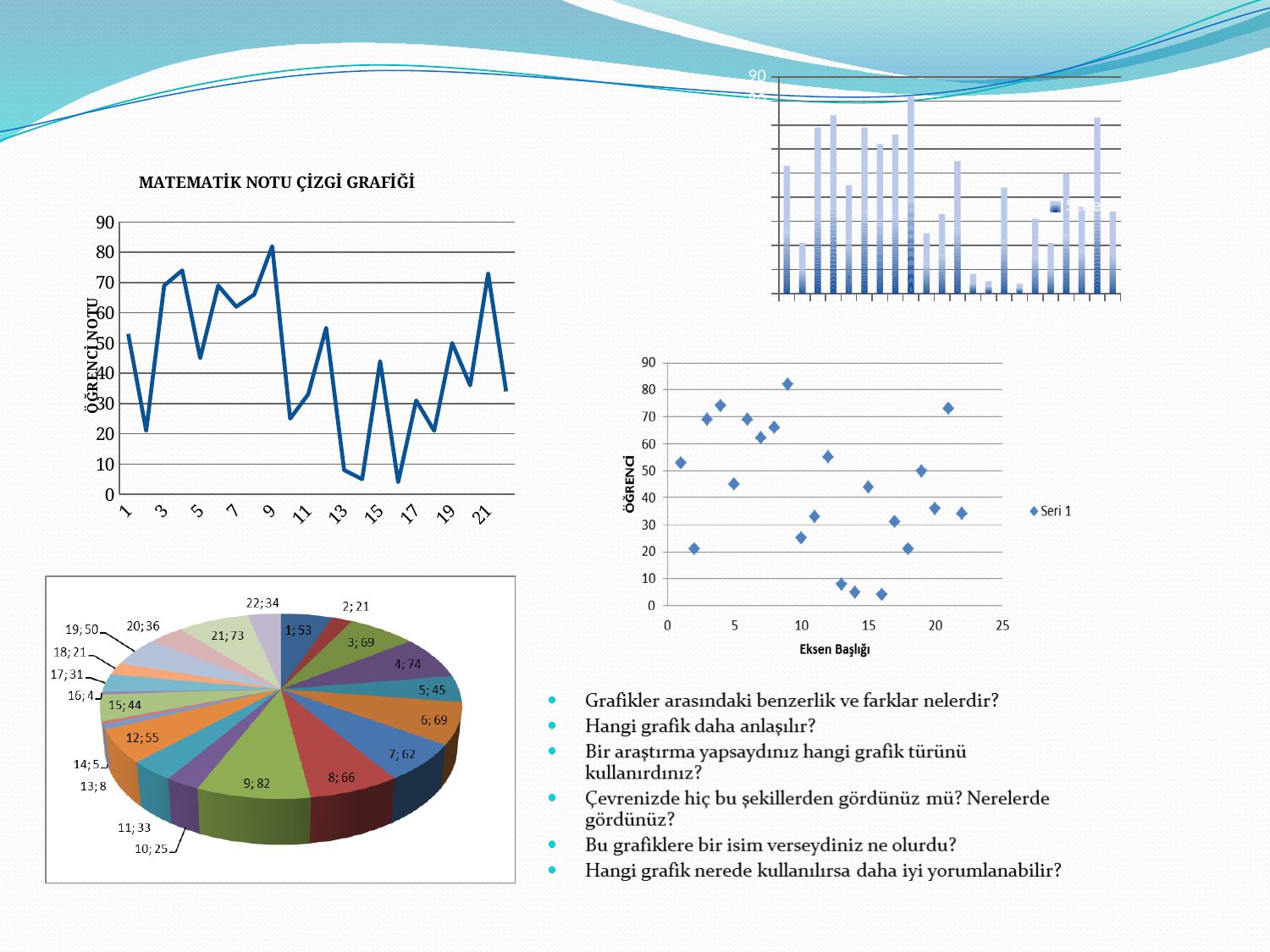
In the pie chart at the bottom left, what is the value for category 21? 73 In the pie chart at the bottom left, which has the larger value, category 21 or category 22? 21 In the pie chart at the bottom left, what is the difference between the values for category 4 and category 2? 53 In the pie chart at the bottom left, what is the value for category 9? 82 How many slices does the pie chart at the bottom left have? 22 In the pie chart at the bottom left, which category has the lowest value? 16 What kind of chart is the chart titled MATEMATİK NOTU ÇİZGİ GRAFİĞİ? line chart What kind of chart is the chart at the bottom left of the slide? pie chart In the pie chart at the bottom left, which category has the highest value? 9 What is the x-axis title of the scatter chart on the right? Eksen Başlığı How many series does the legend of the scatter chart on the right list? 1 In the chart titled MATEMATİK NOTU ÇİZGİ GRAFİĞİ, is the value at x = 16 greater or less than 10? less